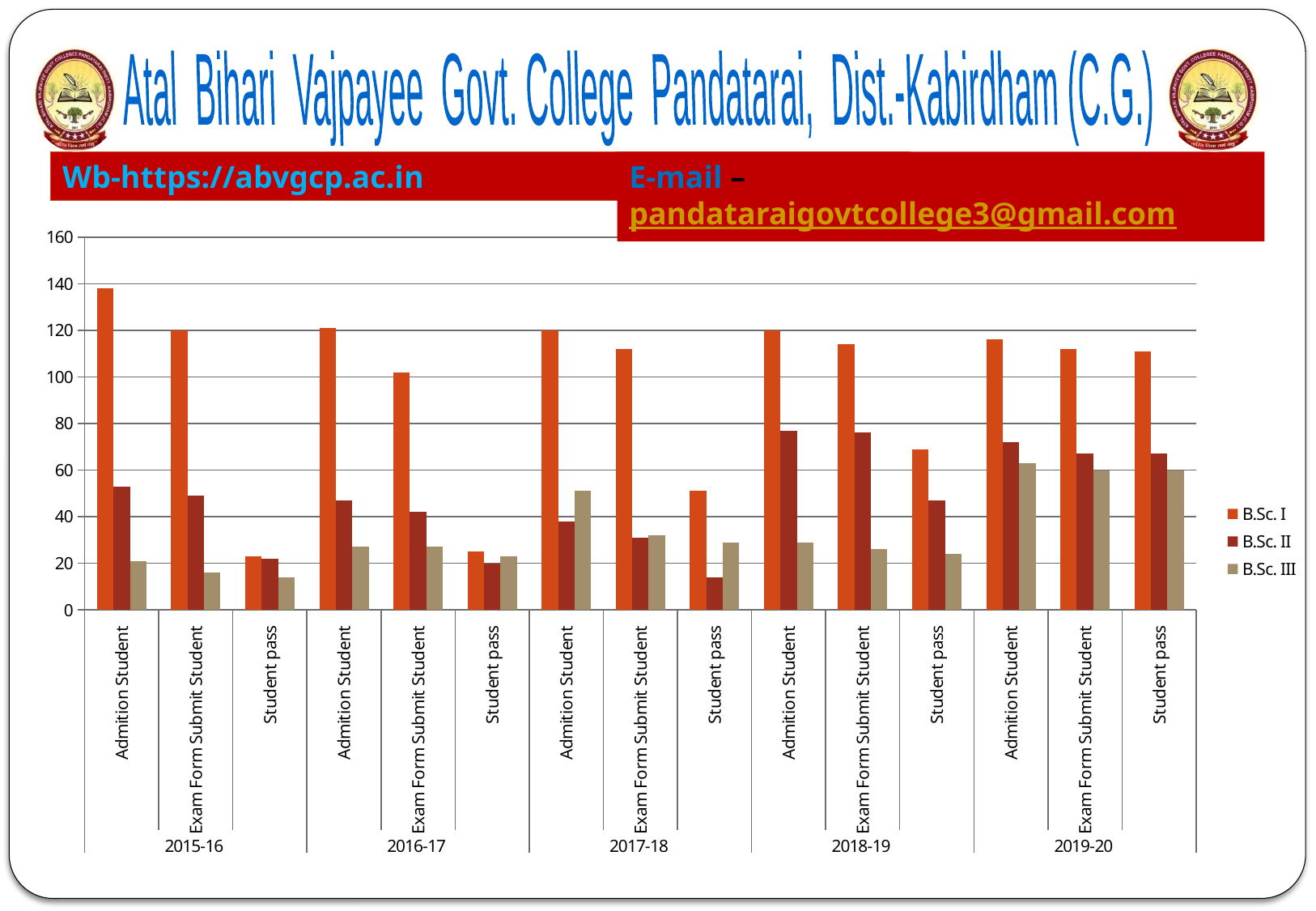
Which year has the larger B.Sc. I value for Admition Student, 2015-16 or 2016-17? 2015-16 For which year and category is the B.Sc. I bar the highest? Admition Student, 2015-16 Which year has the larger B.Sc. III value for Admition Student, 2017-18 or 2018-19? 2017-18 Is the B.Sc. III value for Student pass in 2015-16 greater or less than 20? less How many series does the legend list? 3 For which year and category is the B.Sc. II bar the lowest? Student pass, 2017-18 Which series is shown in orange in the legend? B.Sc. I How many academic years are shown along the x axis? 5 Is the B.Sc. I value for Admition Student in 2015-16 greater or less than 120? greater What kind of chart is shown on the slide? bar chart Is the B.Sc. II value for Admition Student in 2018-19 greater or less than 60? greater Which series is shown in the grey-tan colour in the legend? B.Sc. III